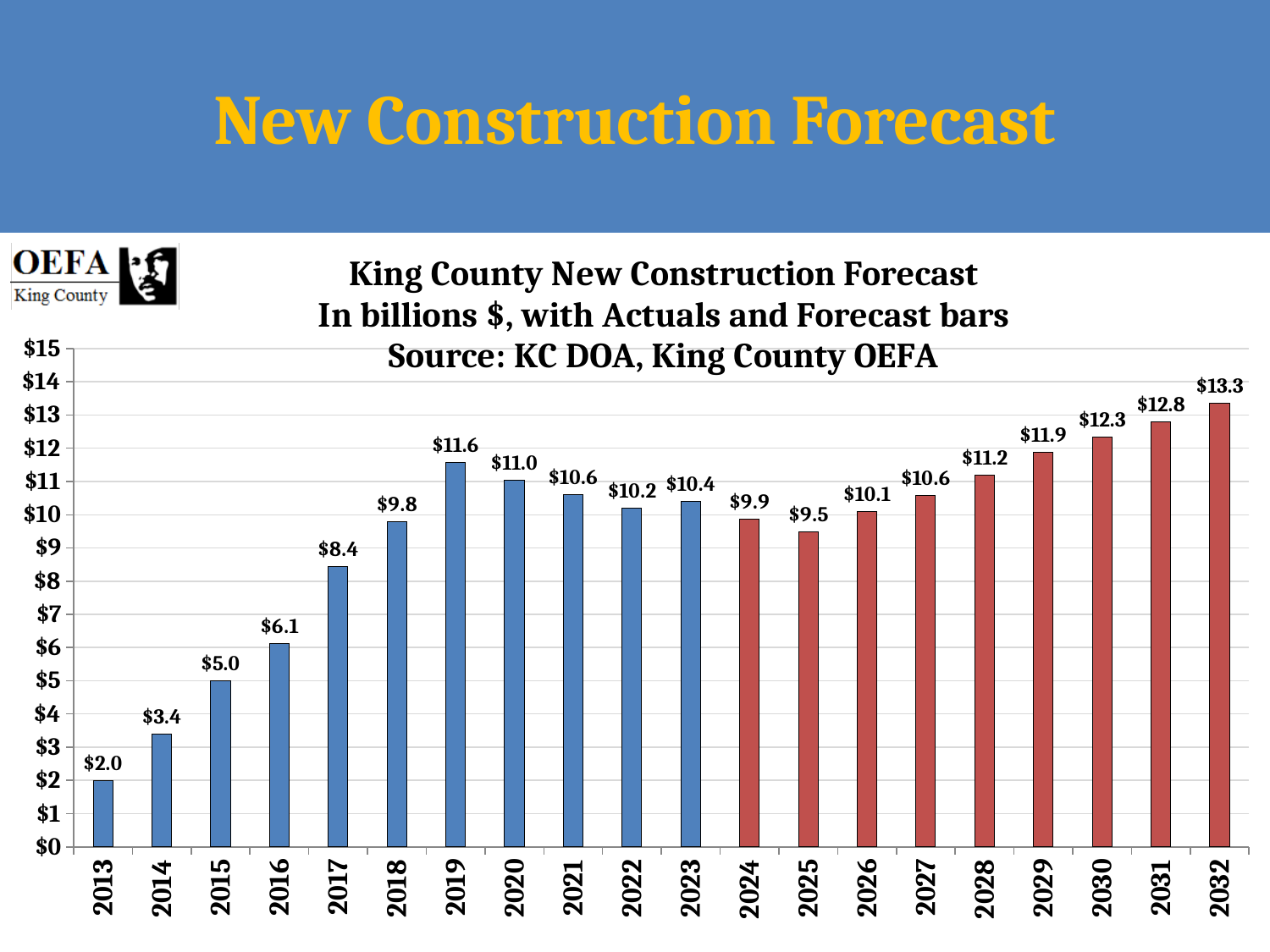
What is the difference between the values for 2019 and 2024? $1.7 Which year has the highest value? 2032 What kind of chart is this? bar chart What is the value for 2025? $9.5 What is the difference between the values for 2032 and 2013? $11.3 Do the values rise or fall from 2013 to 2019? rise Which is larger, the value for 2020 or the value for 2028? 2028 What is the value for 2013? $2.0 Which year has the lowest value? 2013 How many years are shown on the x axis? 20 What is the value for 2019? $11.6 Is the value for 2017 greater or less than $8? greater